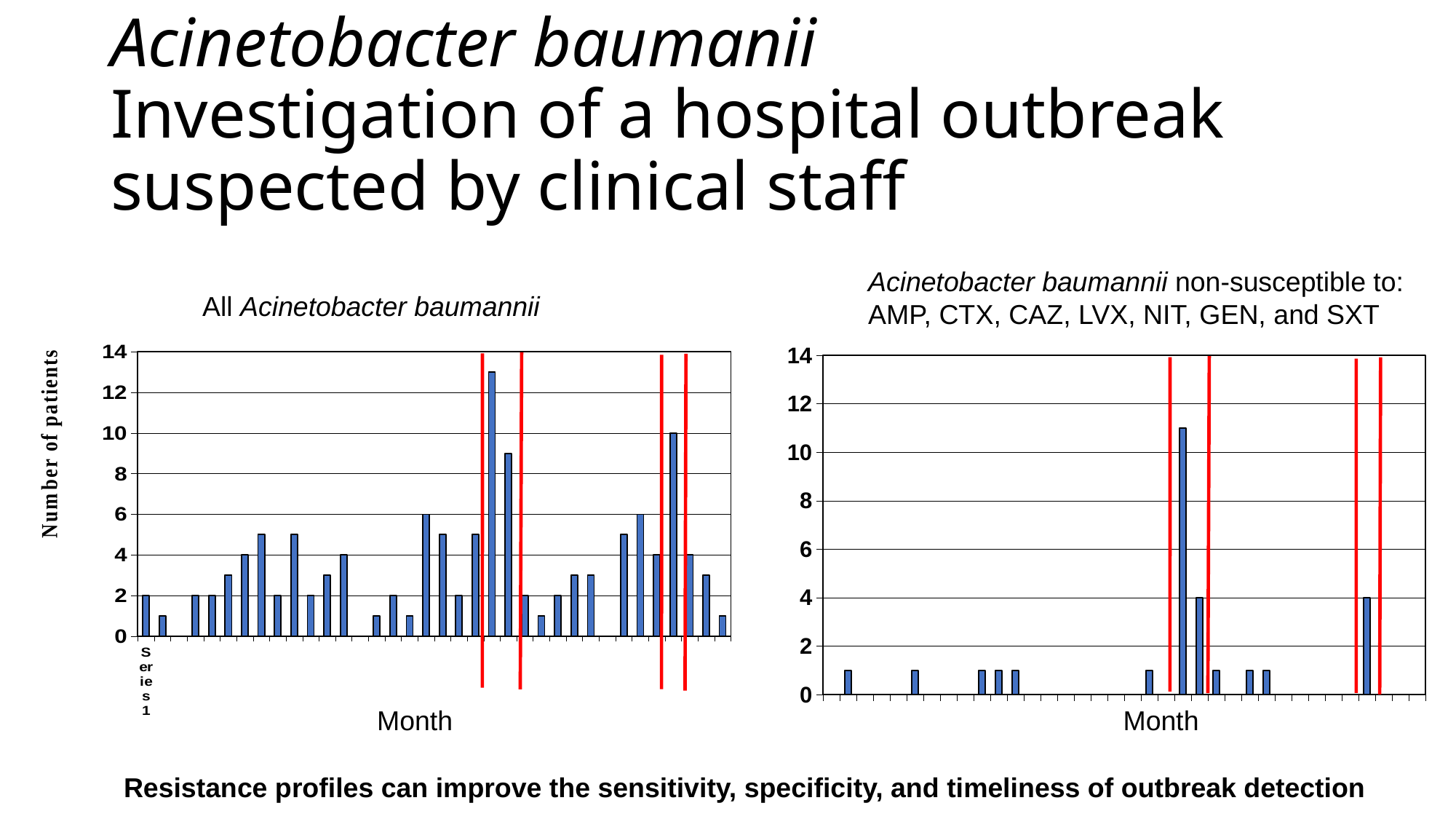
What kind of chart is the right chart showing Acinetobacter baumannii non-susceptible to AMP, CTX, CAZ, LVX, NIT, GEN, and SXT? bar chart What is the y-axis label of the left chart? Number of patients In the left chart, is the tallest bar greater or less than 12? greater In the left chart, is the shortest bar greater or less than 2? less In the right chart, are the shortest bars greater or less than 2? less What is the x-axis label shown under both charts? Month Which chart has the taller maximum bar, the left chart or the right chart? the left chart What kind of chart is the left chart titled 'All Acinetobacter baumannii'? bar chart In the left chart, what value does the bar between the second pair of red vertical lines reach? 10 In the right chart, what value does the bar immediately to the right of the tallest bar reach? 4